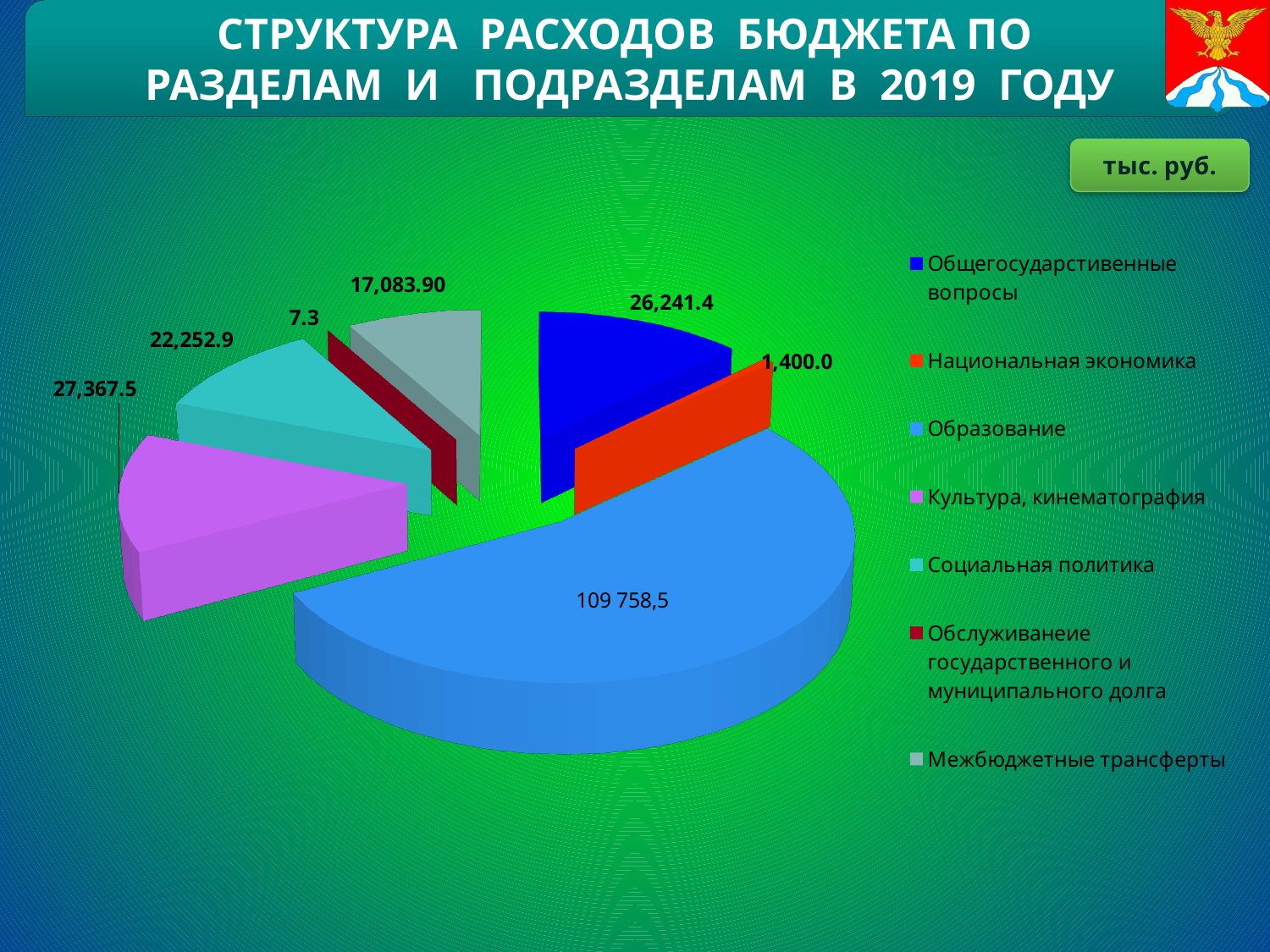
What is the value for Межбюджетные трансферты? 17,083.90 Which is larger: Социальная политика or Межбюджетные трансферты? Социальная политика Which category has the largest slice of the pie? Образование What unit of measurement is indicated on the slide for the chart values? тыс. руб. How many slices does the pie chart have? 7 What is the value for Образование? 109 758,5 What is the value for Социальная политика? 22,252.9 What is the value for Национальная экономика? 1,400.0 What type of chart is shown on the slide? Pie chart What is the difference between the values for Культура, кинематография and Общегосударственные вопросы? 1,126.1 What is the value for Общегосударственные вопросы? 26,241.4 Which category has the smallest value? Обслуживание государственного и муниципального долга